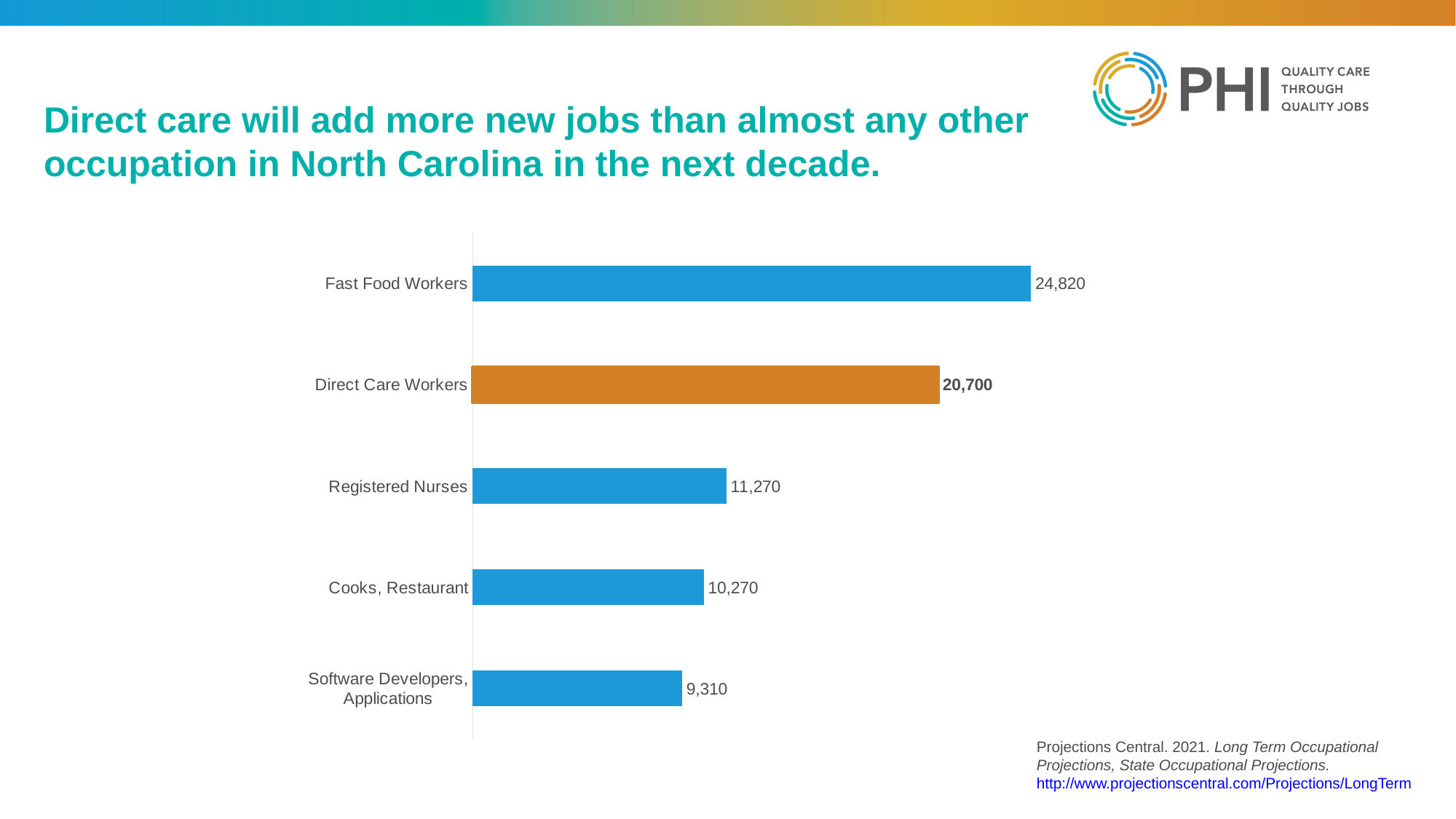
What is the difference between the values for Registered Nurses and Cooks, Restaurant? 1,000 What is the value shown for Software Developers, Applications? 9,310 What is the value shown for Cooks, Restaurant? 10,270 What is the difference between the values for Fast Food Workers and Direct Care Workers? 4,120 What is the value shown for Registered Nurses? 11,270 Which occupation has the lowest value in the chart? Software Developers, Applications Which occupation has the highest value in the chart? Fast Food Workers What is the value shown for Direct Care Workers? 20,700 What kind of chart is shown on the slide? Bar chart How many occupations are shown in the chart? 5 Which is larger, the value for Direct Care Workers or the value for Registered Nurses? Direct Care Workers What is the value shown for Fast Food Workers? 24,820